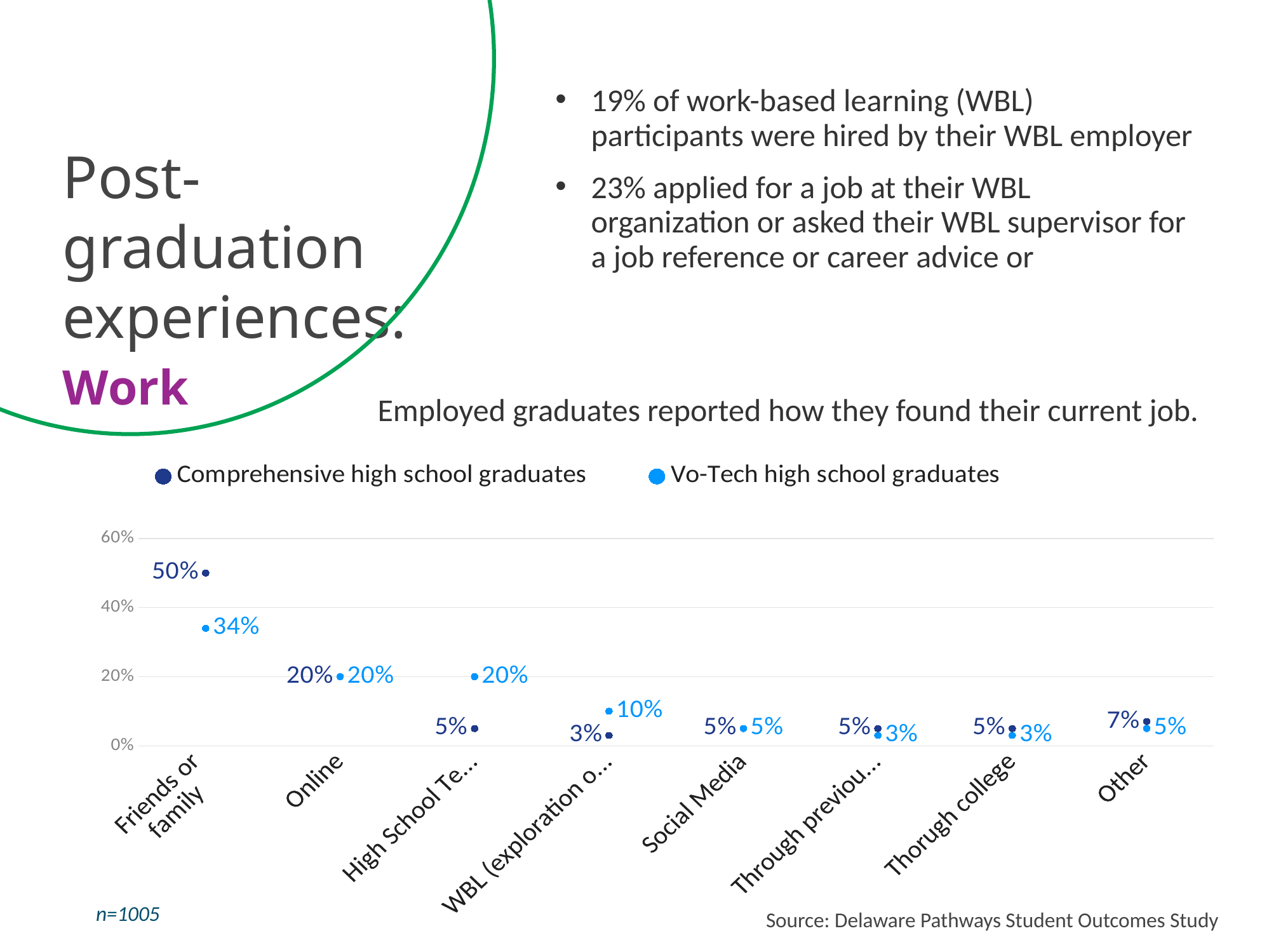
What percentage of Comprehensive high school graduates found their current job through Friends or family? 50% What percentage of Vo-Tech high school graduates found their current job through Friends or family? 34% What is the difference between Comprehensive and Vo-Tech high school graduates in the Friends or family category? 16% How many series does the chart legend list? 2 Which category has the highest value for Vo-Tech high school graduates? Friends or family What is the sample size noted below the chart? n=1005 Which category has the highest value for Comprehensive high school graduates? Friends or family What is the value for Comprehensive high school graduates in the Other category? 7% How many categories are shown on the x axis of the chart? 8 What is the value for Vo-Tech high school graduates in the Online category? 20% What is the value for Vo-Tech high school graduates in the Social Media category? 5% In the Other category, which series has the larger value, Comprehensive or Vo-Tech high school graduates? Comprehensive high school graduates